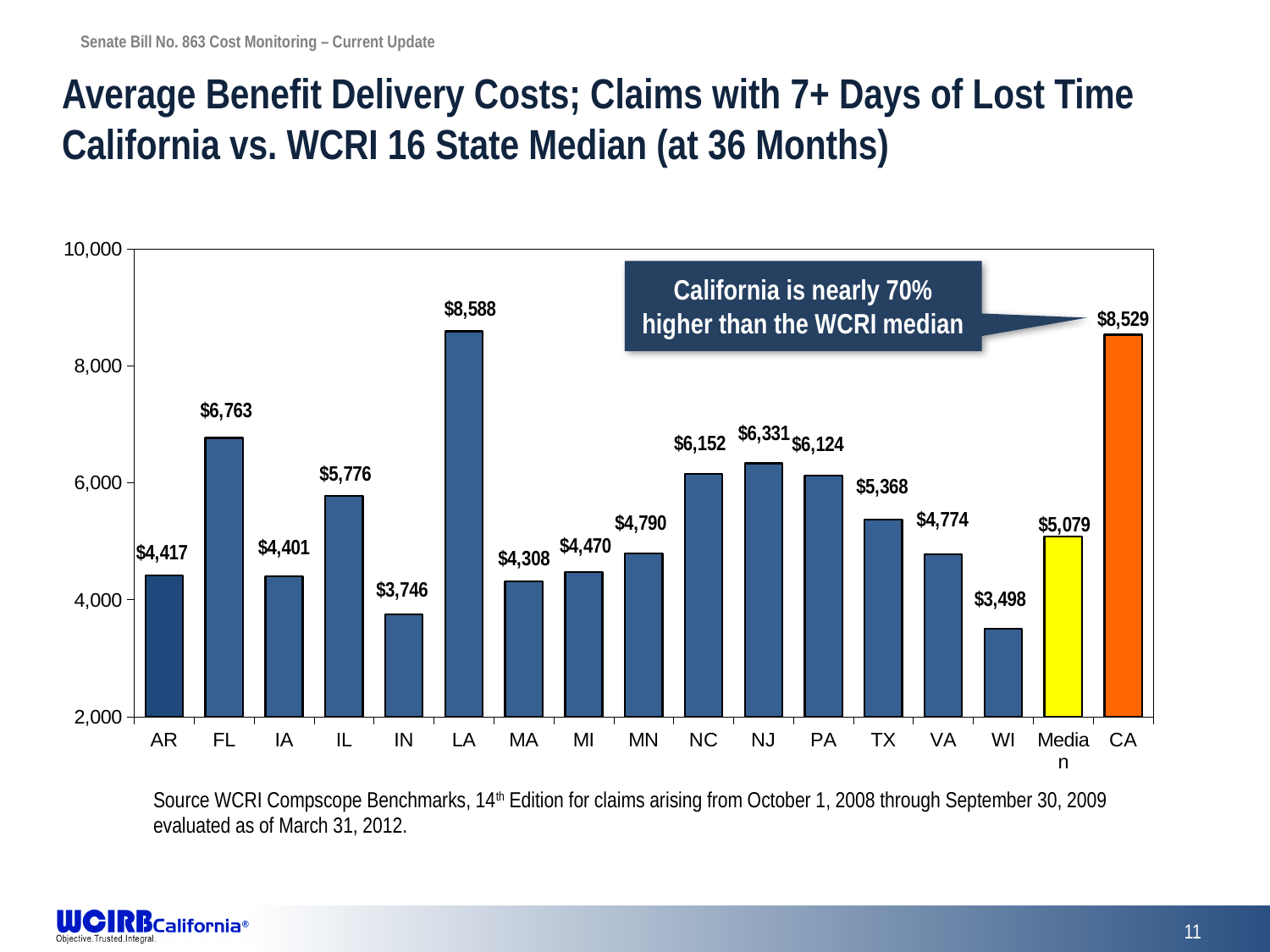
What is the average benefit delivery cost for Louisiana (LA)? $8,588 How much higher is California's cost than the WCRI Median? $3,450 How many bars are shown in the chart? 17 Which state has the highest average benefit delivery cost? LA What is the average benefit delivery cost for California (CA)? $8,529 Which has a higher average benefit delivery cost, FL or NJ? FL What is the value shown for the WCRI Median bar? $5,079 Is the value for TX greater or less than 6,000? less What colour is the CA bar? Orange What type of chart is shown on the slide? Bar chart Which state has the lowest average benefit delivery cost? WI What is the value shown for Wisconsin (WI)? $3,498